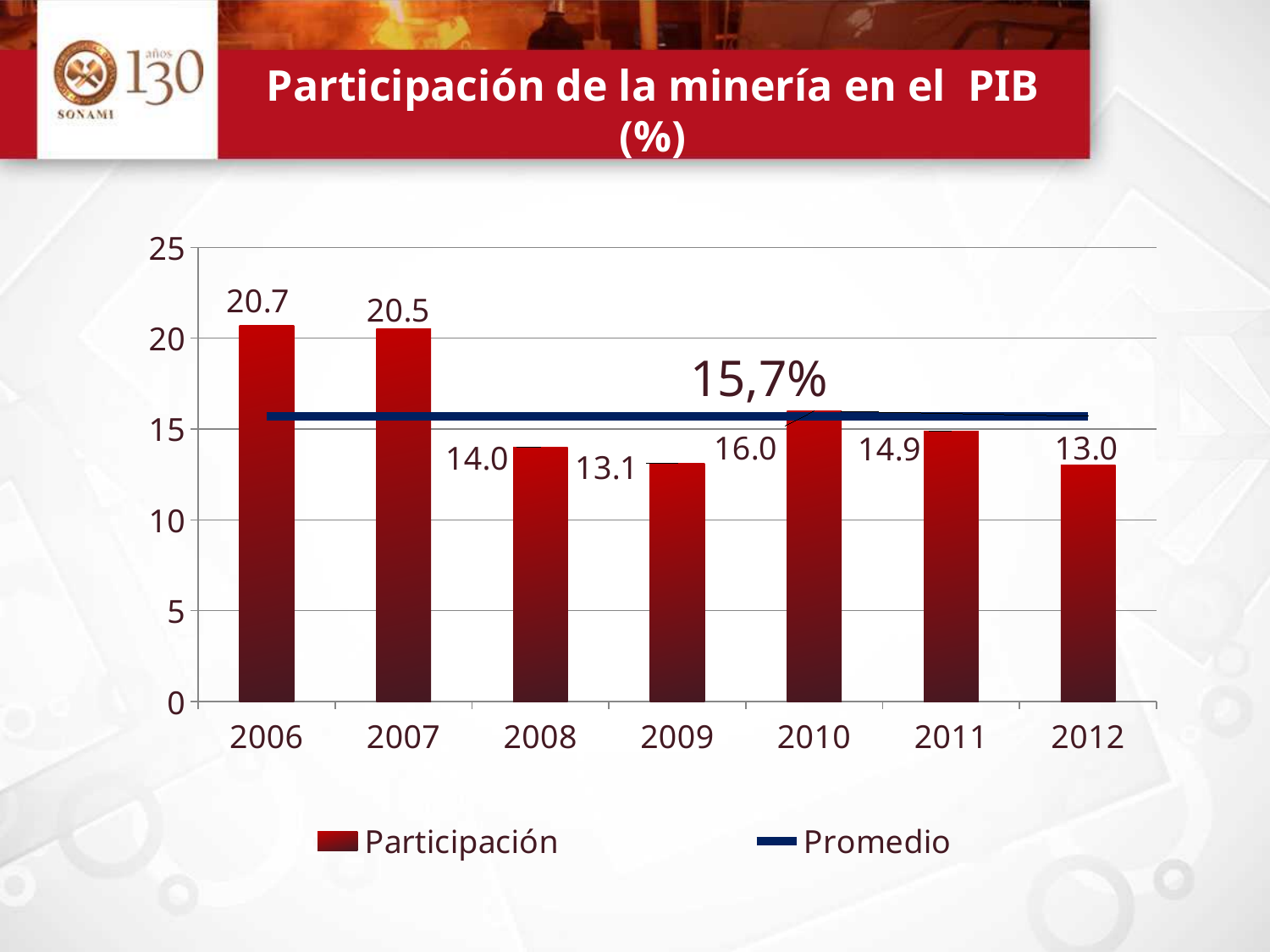
How many years are shown on the x axis? 7 What is the title of the chart? Participación de la minería en el PIB (%) How many series does the legend list? 2 What value is labelled on the Promedio line? 15,7% Is the Participación value for 2008 greater or less than 15? less Which is larger, the Participación value for 2010 or for 2011? 2010 What is the Participación value for 2009? 13.1 Which year has the lowest Participación value? 2012 Which year has the highest Participación value? 2006 What is the Participación value for 2011? 14.9 What is the Participación value for 2006? 20.7 What is the difference between the Participación values for 2006 and 2012? 7.7